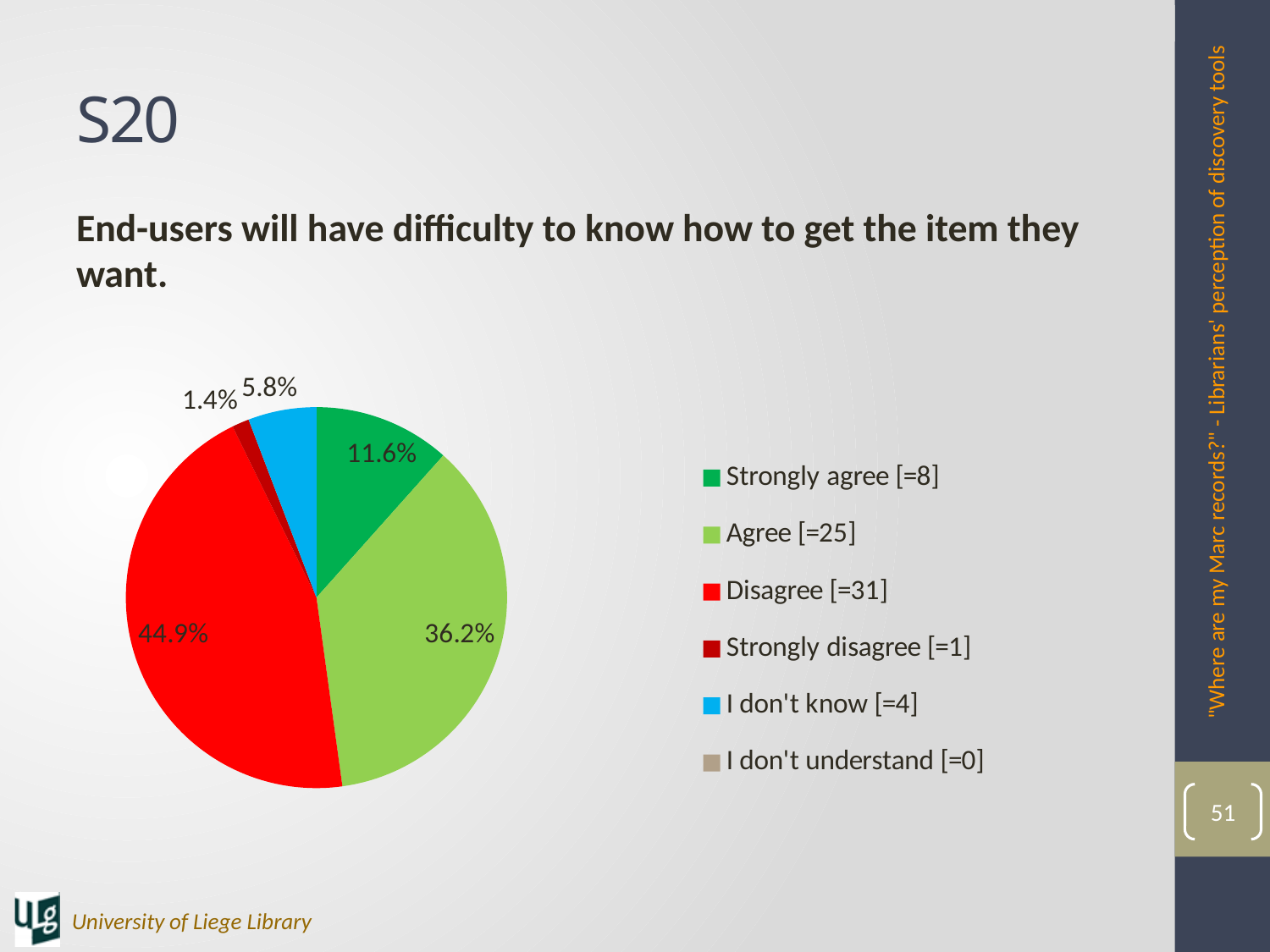
What percentage of the pie is labelled for the Strongly agree slice? 11.6% According to the legend, how many respondents chose Agree? 25 What percentage of the pie is labelled for the Agree slice? 36.2% What kind of chart is shown on the slide? pie chart Which slice is larger, Strongly agree or I don't know? Strongly agree Which response category with a non-zero count has the smallest share of the pie? Strongly disagree What percentage of the pie is labelled for the Strongly disagree slice? 1.4% Which response category has the largest share of the pie? Disagree What percentage of the pie is labelled for the I don't know slice? 5.8% What is the difference in percentage points between the Disagree slice and the Agree slice? 8.7 How many response categories does the legend list? 6 What percentage of the pie is labelled for the Disagree slice? 44.9%